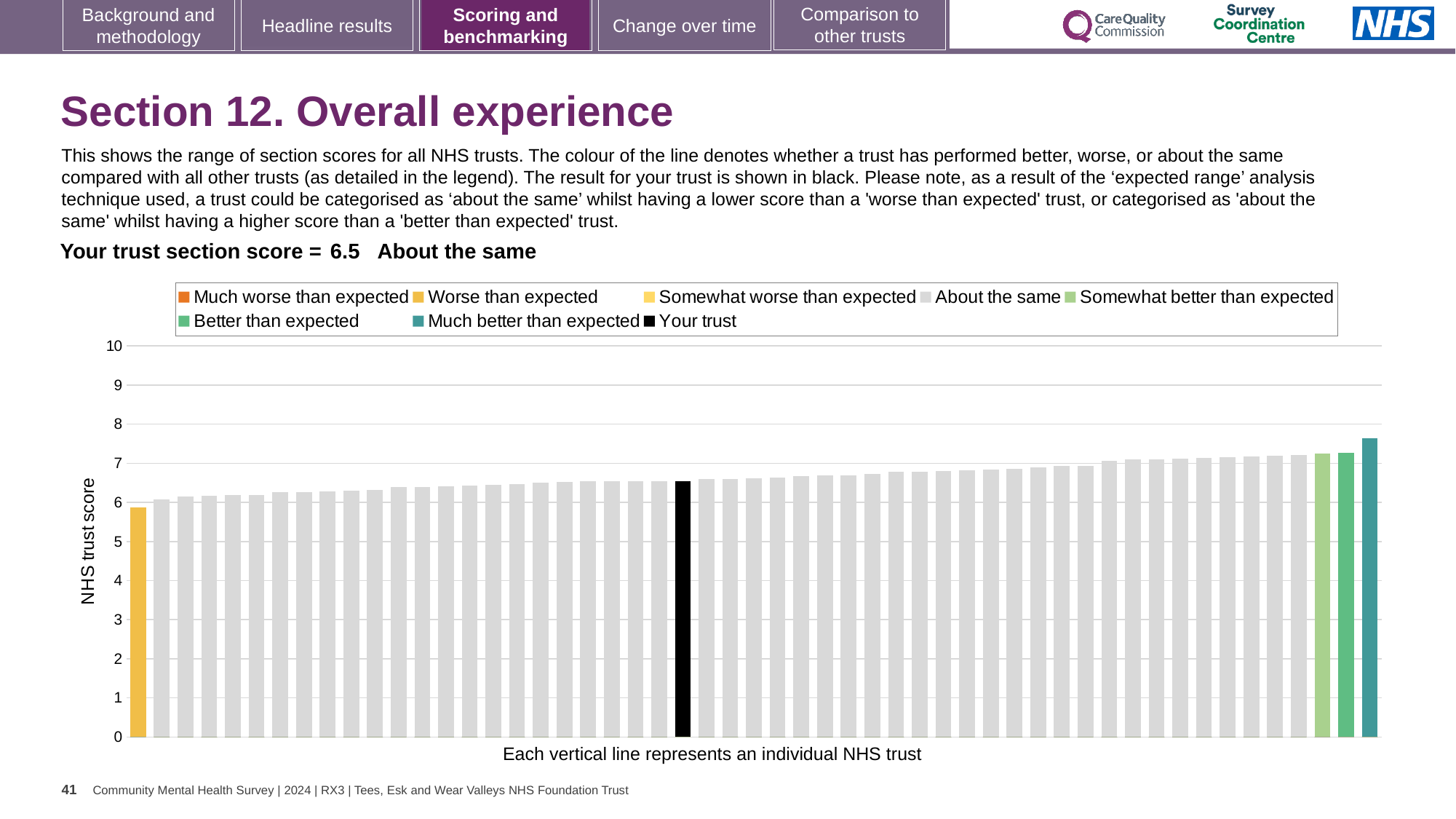
What is the title of the vertical axis? NHS trust score Is the value of the tallest bar greater or less than 8? less Is the value of the black bar (your trust) greater or less than 6? greater Is the value of the leftmost (yellow) bar greater or less than 6? less Do the bar values rise or fall from left to right along the x axis? rise Which legend category does the tallest bar belong to? Much better than expected Which is larger, the leftmost bar or the rightmost bar? the rightmost bar Which benchmarking category is your trust placed in for Section 12? About the same What kind of chart is shown on the slide? bar chart What is the section score for your trust shown on the slide? 6.5 How many entries does the chart legend list? 8